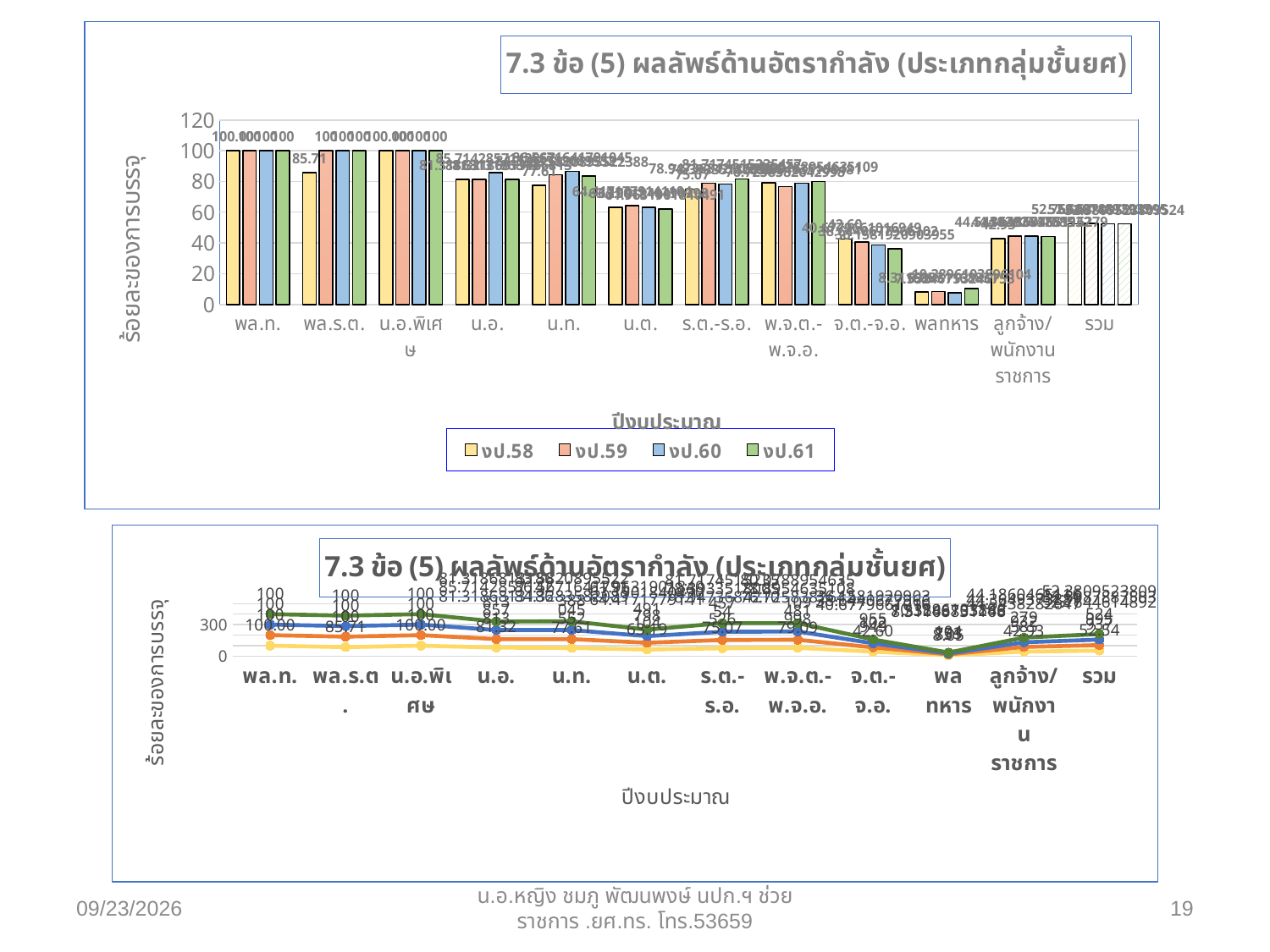
What kind of chart is the bottom chart on the slide? line chart In the top bar chart, how many categories are shown along the x axis? 12 In the top bar chart, what are the four legend entries? งป.58, งป.59, งป.60, งป.61 In the top bar chart, is the value for พลทหาร in the งป.58 series greater or less than 20? less In the top bar chart, what is the value for พล.ท. in the งป.58 series? 100.00 What kind of chart is the top chart on the slide? bar chart In the top bar chart, what is the value for พล.ร.ต. in the งป.58 series? 85.71 In the top bar chart, which is larger in the งป.58 series: พล.ท. or พล.ร.ต.? พล.ท. In the top bar chart, how many series does the legend list? 4 In the top bar chart, which category has the lowest value in the งป.58 series? พลทหาร In the top bar chart, is the value for น.ท. in the งป.58 series greater or less than 60? greater In the top bar chart, what is the label on the vertical axis? ร้อยละของการบรรจุ